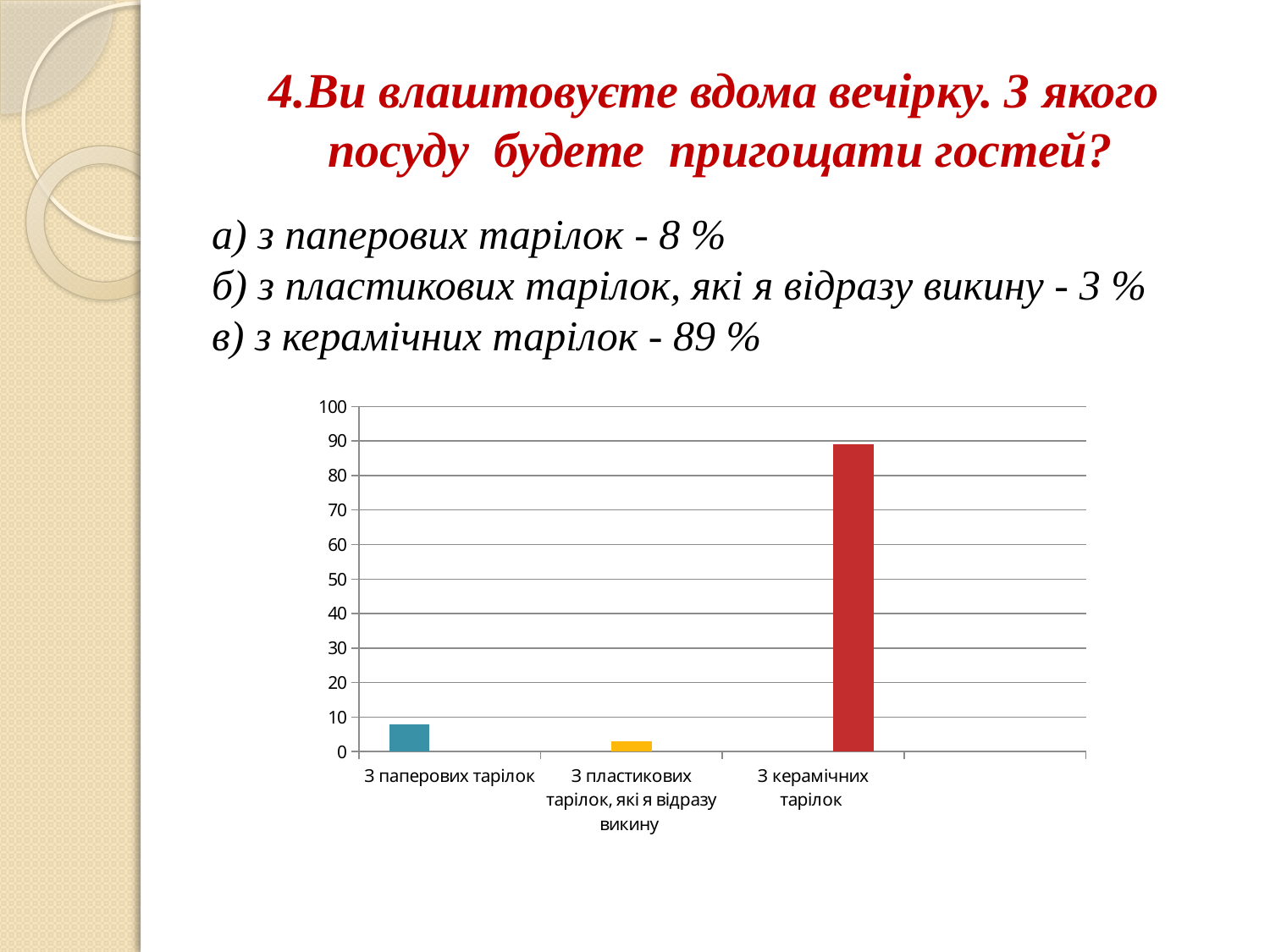
Which category has the highest bar in the chart? З керамічних тарілок According to the slide, what percentage chose 'з паперових тарілок'? 8 % Is the value for 'З паперових тарілок' greater or less than 10? less Which category has the lowest bar in the chart? З пластикових тарілок, які я відразу викину What is the highest value shown on the vertical axis of the chart? 100 Is the value for 'З керамічних тарілок' greater or less than 80? greater How many categories are shown on the x axis of the chart? 3 According to the slide, what percentage chose 'з керамічних тарілок'? 89 % What is the difference between the percentage for ceramic plates (89 %) and paper plates (8 %) given on the slide? 81 % Is the value for 'З пластикових тарілок, які я відразу викину' greater or less than 10? less What kind of chart is shown on the slide? bar chart Which is larger: the value for 'З паперових тарілок' or the value for 'З пластикових тарілок, які я відразу викину'? З паперових тарілок